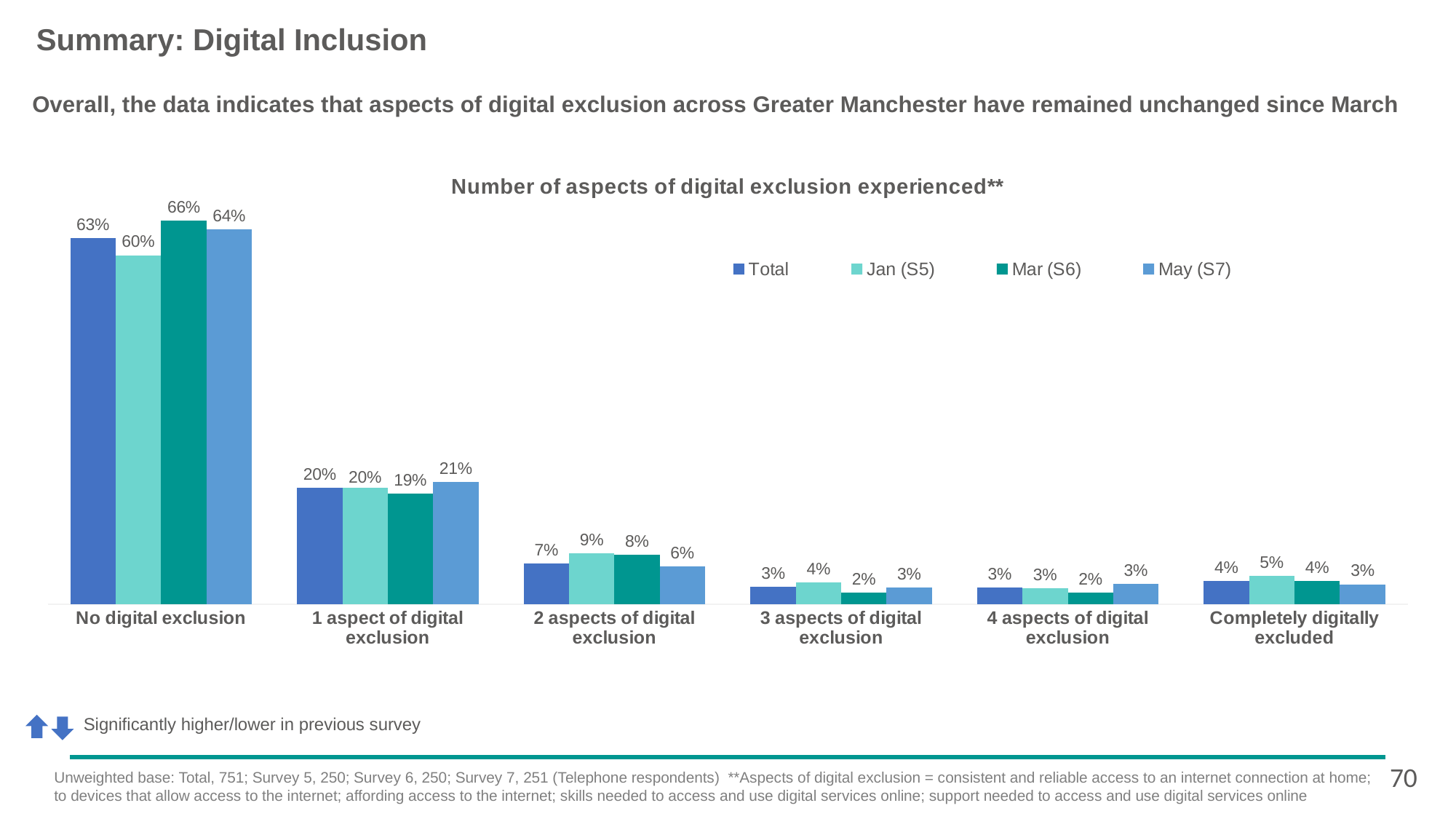
What is the title of the chart? Number of aspects of digital exclusion experienced** What is the Jan (S5) value for '2 aspects of digital exclusion'? 9% What is the difference between the Mar (S6) and Jan (S5) values for 'No digital exclusion'? 6 percentage points What is the Total value for 'No digital exclusion'? 63% How many series does the legend list? 4 What kind of chart is shown on the slide? Bar chart What is the Mar (S6) value for 'No digital exclusion'? 66% How many categories are shown on the x axis? 6 Which category has the highest Total value? No digital exclusion Which survey wave has the lowest value for 'No digital exclusion'? Jan (S5) What is the May (S7) value for '1 aspect of digital exclusion'? 21% Which is larger for '2 aspects of digital exclusion': the Jan (S5) value or the May (S7) value? Jan (S5)